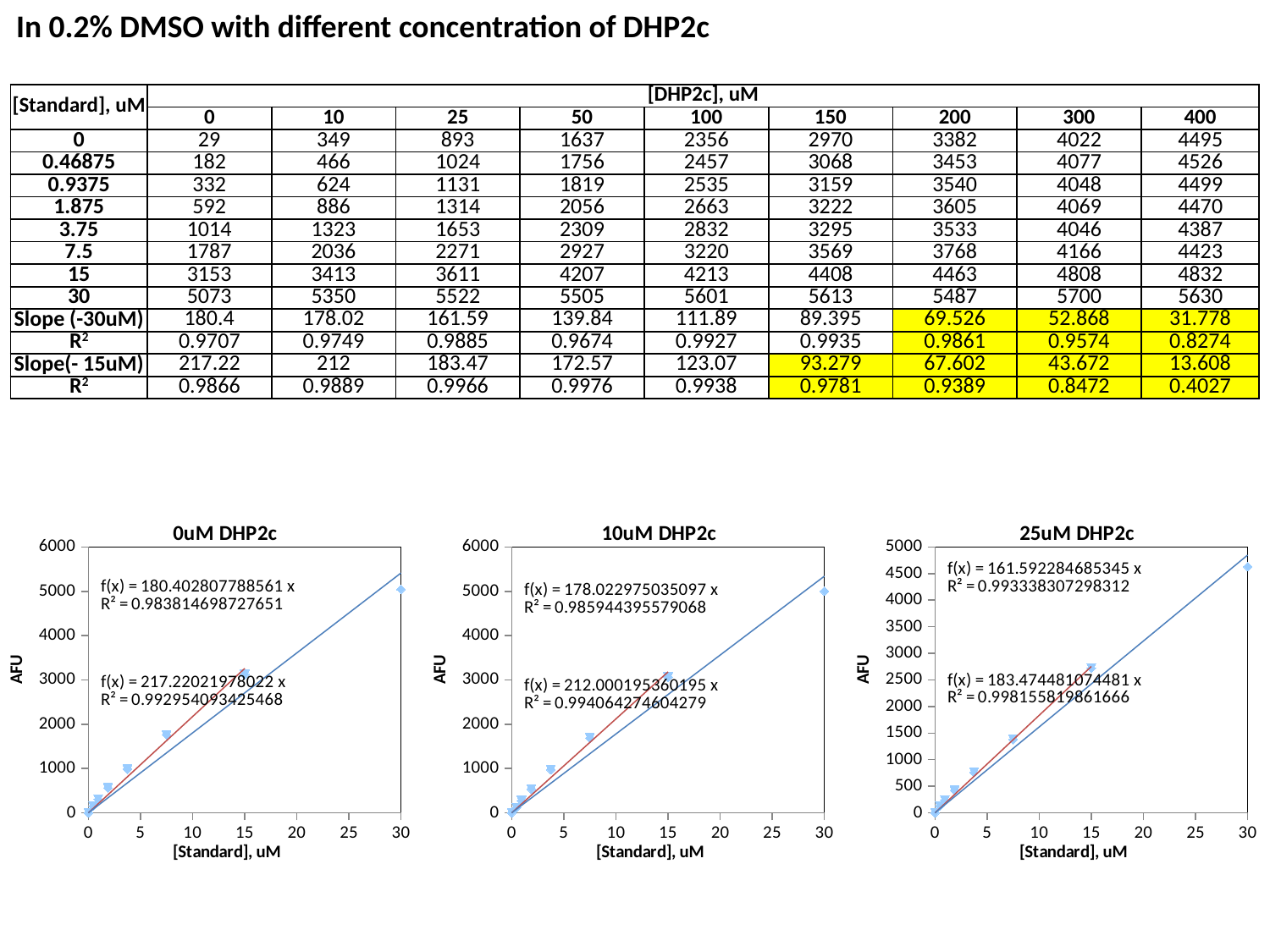
In the '25uM DHP2c' chart, which has the higher AFU value: [Standard] = 15 uM or [Standard] = 30 uM? 30 uM In the '25uM DHP2c' chart, is the AFU value at [Standard] = 7.5 uM greater or less than 2000? less What is the x-axis label on the '10uM DHP2c' chart? [Standard], uM In the '10uM DHP2c' chart, do the AFU values rise or fall as [Standard] increases? rise In the '10uM DHP2c' chart, is the AFU value at [Standard] = 30 uM greater or less than 4000? greater How many charts are shown on the slide? 3 In the '0uM DHP2c' chart, is the AFU value at [Standard] = 15 uM greater or less than 2000? greater In the '0uM DHP2c' chart, what R² value is shown with the equation f(x) = 180.402807788561 x? 0.983814698727651 What kind of chart is the '0uM DHP2c' chart? scatter chart In the '25uM DHP2c' chart, what slope is shown in the equation for the trendline with R² = 0.998155819861666? 183.474481074481 What is the highest tick value on the y axis of the '25uM DHP2c' chart? 5000